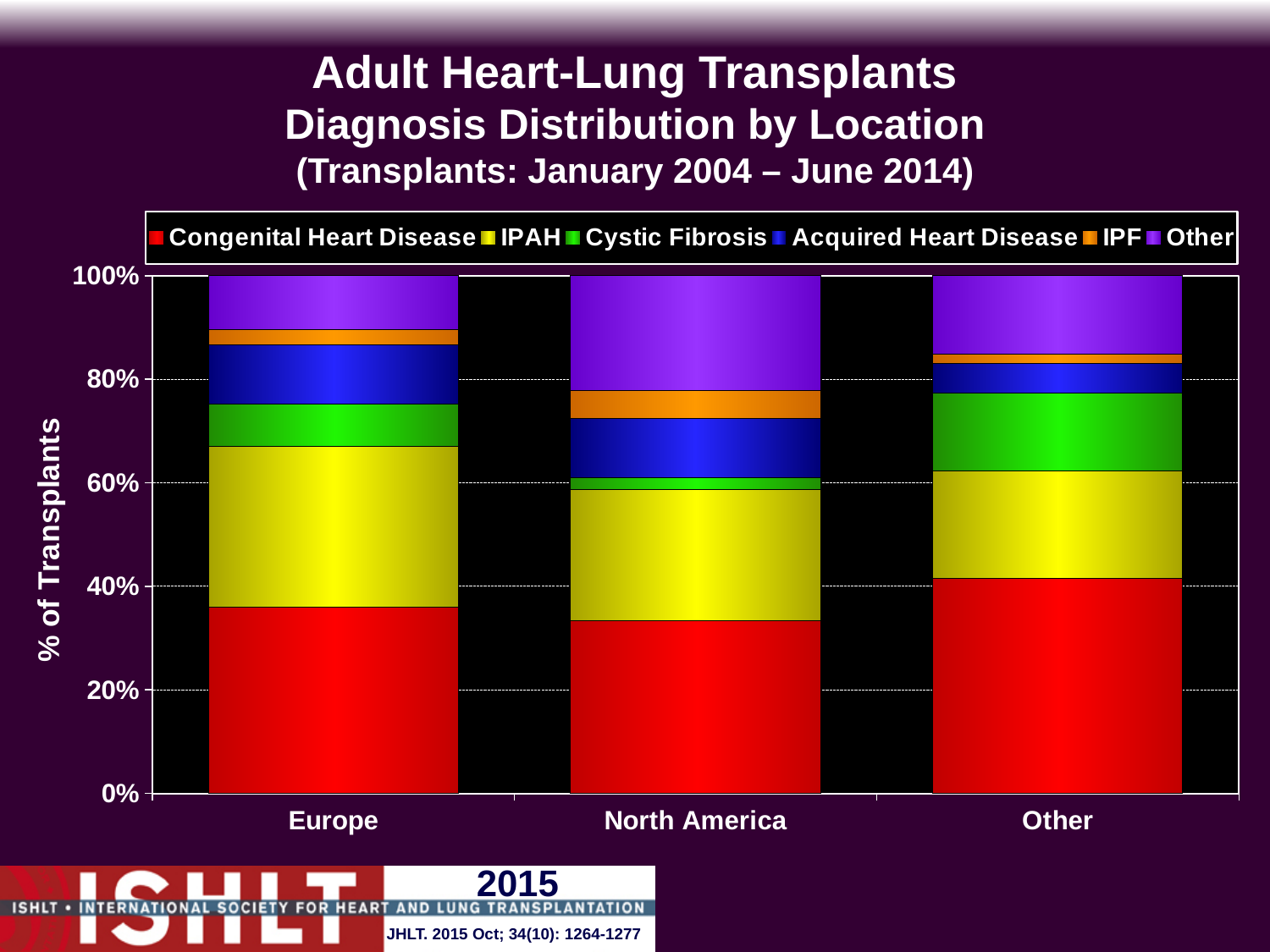
Which colour represents IPAH in the chart? Yellow How many diagnosis categories does the legend list? 6 What kind of chart is shown on the slide? Stacked bar chart Is the Congenital Heart Disease share for North America greater or less than 40%? less Which location has the smallest Cystic Fibrosis segment? North America Is the Congenital Heart Disease share for Other greater or less than 60%? less How many locations are shown on the x axis of the chart? 3 Which location has the largest 'Other' diagnosis segment? North America What is the label on the y axis of the chart? % of Transplants Is the Congenital Heart Disease share for Europe greater or less than 40%? less Is the Congenital Heart Disease segment larger for Other or for North America? Other Which location has the largest Cystic Fibrosis segment? Other